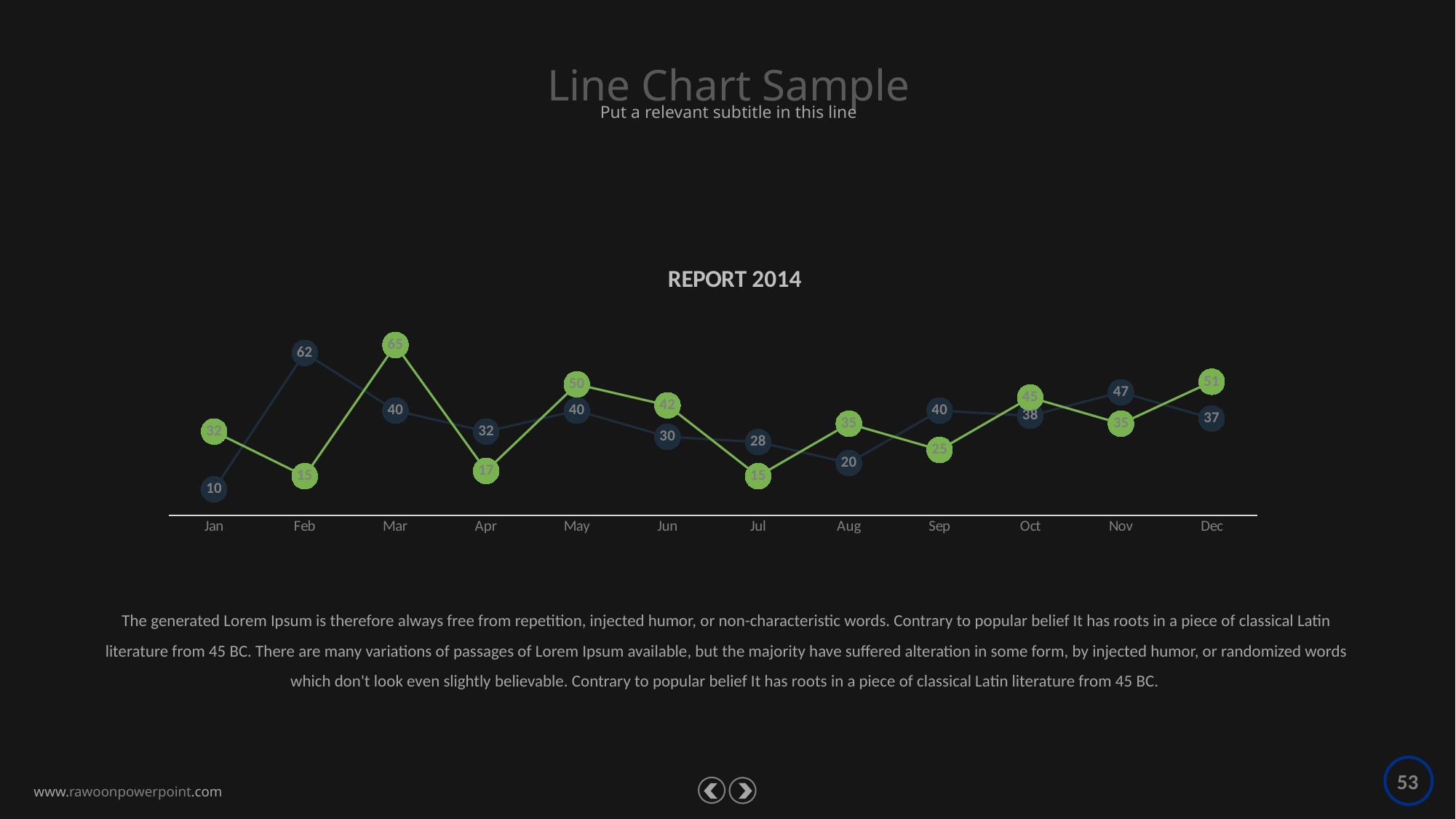
What is the value of the green line in March? 65 In which month does the dark blue line have its lowest value? Jan What is the difference between the green line and the dark blue line in January? 22 Does the dark blue line rise or fall from October to November? rise What is the value of the green line in December? 51 What type of chart is shown on the slide? line chart Which line has the higher value in November, the green line or the dark blue line? dark blue line In which month does the green line reach its highest value? Mar What is the difference between the green line's values in March and April? 48 What is the value of the dark blue line in February? 62 What is the title of the chart? REPORT 2014 How many months are shown on the x axis of the chart? 12